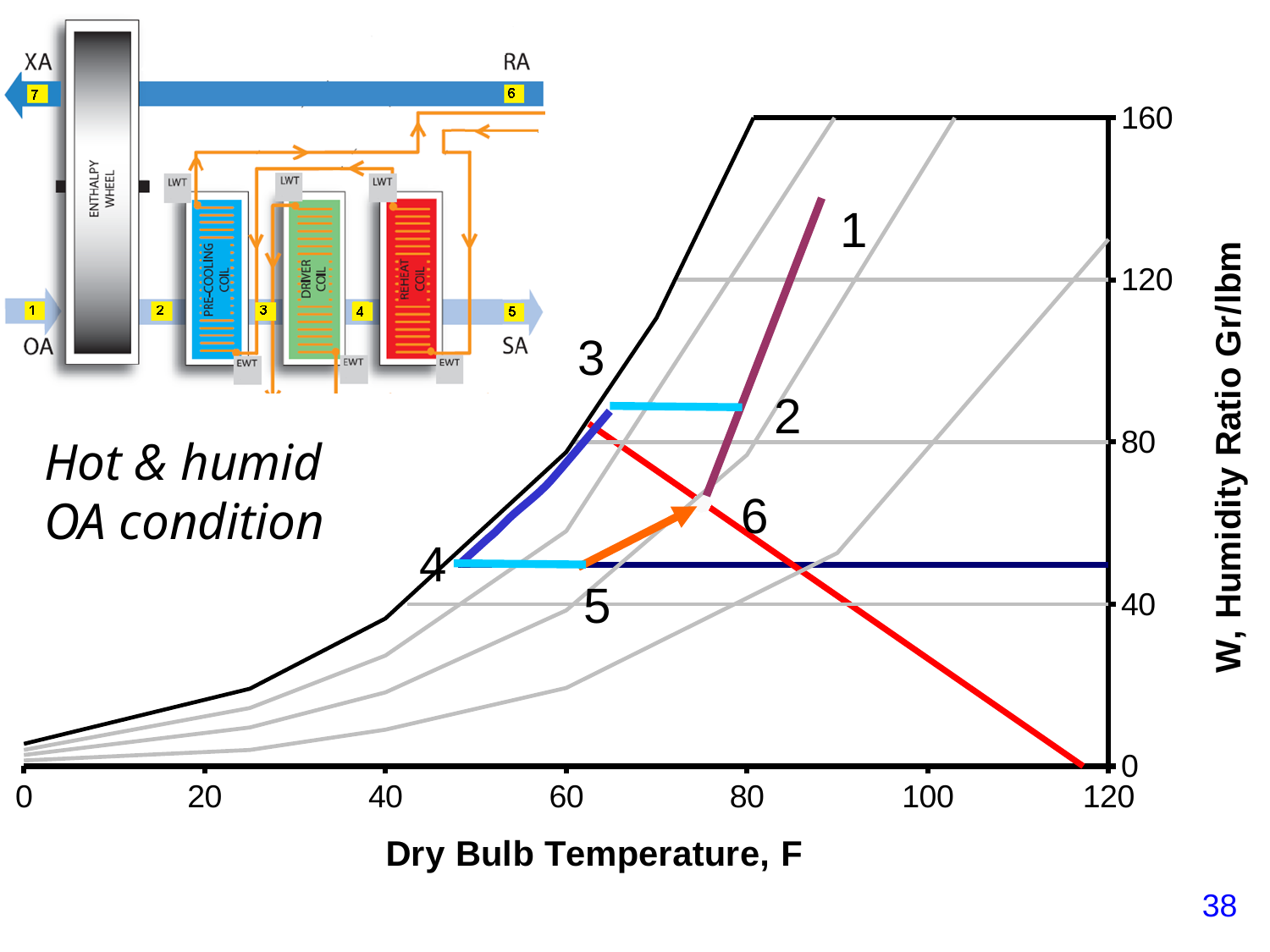
Which point has the higher dry bulb temperature, point 2 or point 3? point 2 Is the humidity ratio at point 3 greater or less than 80? greater Is the humidity ratio at point 4 greater or less than 80? less What is the title of the y axis of the chart? W, Humidity Ratio Gr/lbm Is the dry bulb temperature at point 4 greater or less than 60? less How many numbered process points are labelled on the chart? 6 What kind of chart is shown on the slide? line chart What is the title of the x axis of the chart? Dry Bulb Temperature, F Which point has the higher humidity ratio, point 1 or point 4? point 1